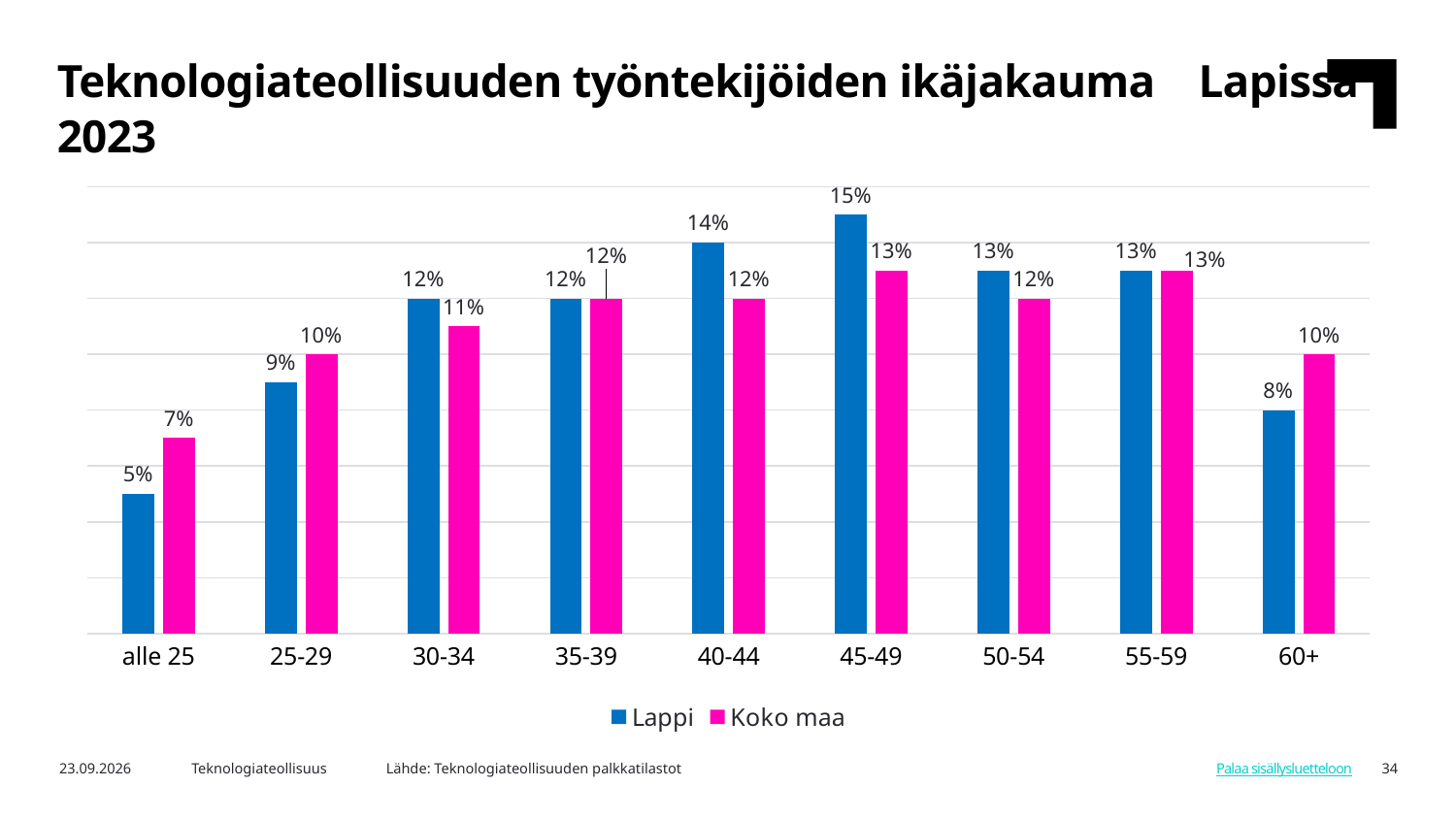
What is the difference between Lappi and Koko maa in the 45-49 age group? 2 percentage points How many age groups are shown on the x axis? 9 Which is larger in the 40-44 age group, Lappi or Koko maa? Lappi Which age group has the lowest value for Lappi? alle 25 What kind of chart is shown on the slide? Bar chart Which age group has the highest value for Lappi? 45-49 What is the value for Lappi in the 45-49 age group? 15% What is the value for Lappi in the 60+ age group? 8% How many series does the legend list? 2 What is the value for Koko maa in the alle 25 age group? 7% Which age group has the lowest value for Koko maa? alle 25 Which is larger in the 60+ age group, Lappi or Koko maa? Koko maa